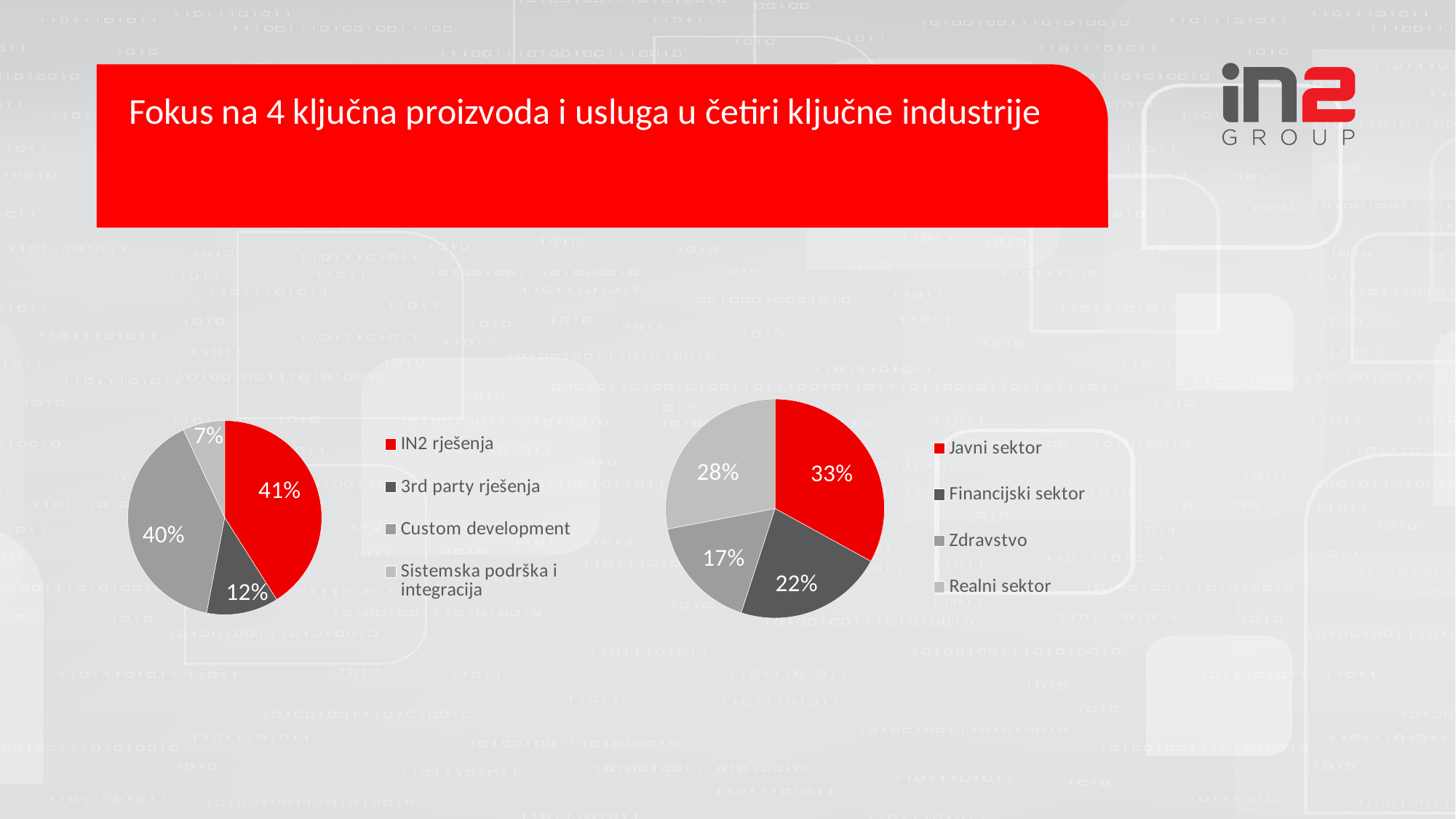
In the right pie chart, what share does Zdravstvo have? 17% In the right pie chart, which is larger, Financijski sektor or Realni sektor? Realni sektor In the left pie chart, what share does Sistemska podrška i integracija have? 7% In the left pie chart, what share does IN2 rješenja have? 41% In the left pie chart, which category has the largest slice? IN2 rješenja What type of chart is the right chart on the slide? Pie chart In the right pie chart, what is the difference between the shares of Javni sektor and Zdravstvo? 16% In the left pie chart, how many categories does the legend list? 4 In the left pie chart, which category has the smallest slice? Sistemska podrška i integracija In the right pie chart, what share does Javni sektor have? 33% In the right pie chart, which sector has the largest slice? Javni sektor In the left pie chart, what is the difference between the shares of Custom development and 3rd party rješenja? 28%